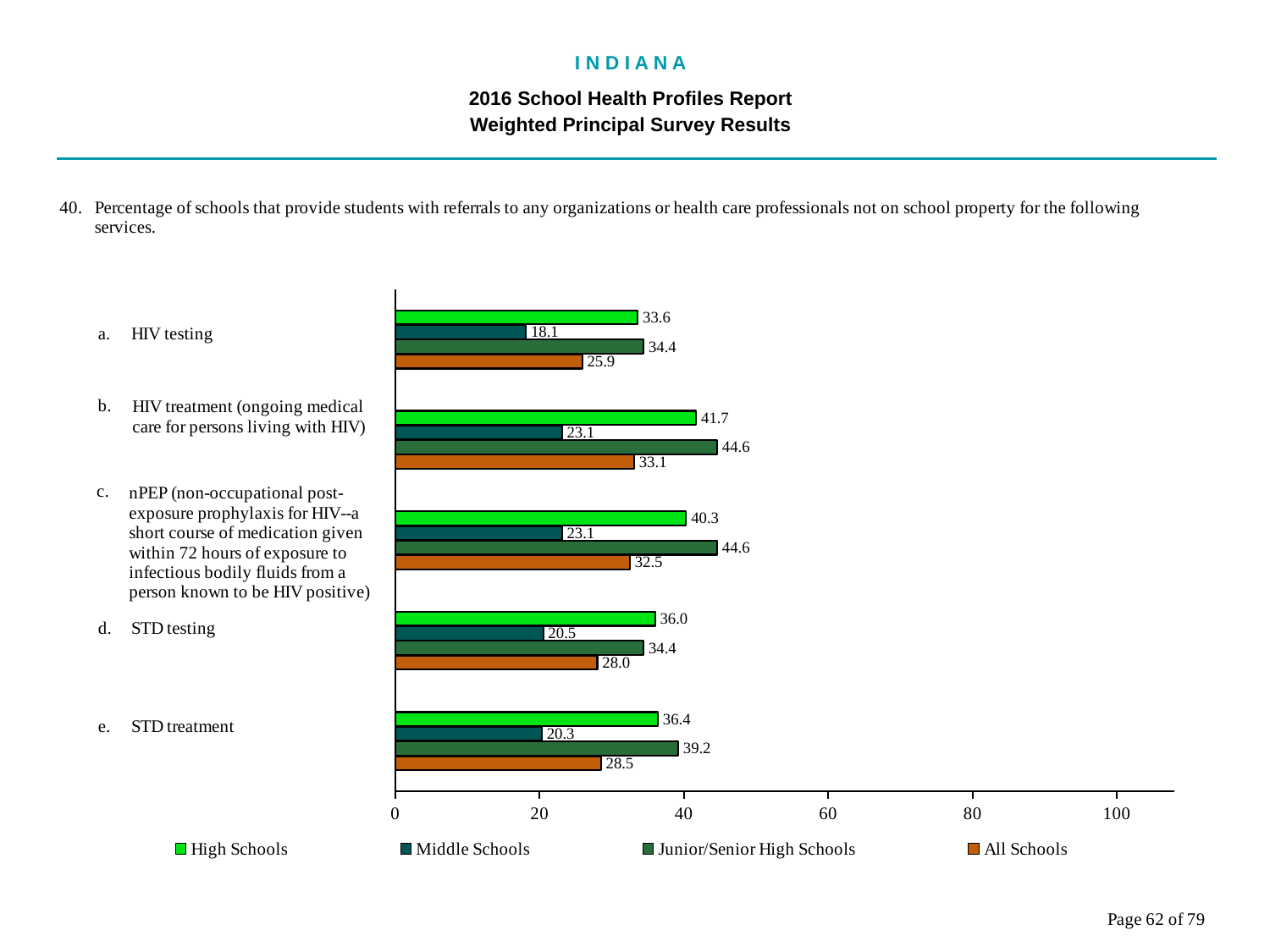
How many service categories are shown in the chart? 5 What is the value for All Schools for nPEP? 32.5 What is the difference between the Junior/Senior High Schools and Middle Schools values for HIV treatment? 21.5 How many series does the legend list? 4 Which category has the lowest value for All Schools? HIV testing What kind of chart is shown on the slide? bar chart Which is larger for STD testing: the High Schools value or the Junior/Senior High Schools value? High Schools Which category has the highest value for Middle Schools? HIV treatment and nPEP (both 23.1) Which legend entry is shown in orange? All Schools Is the value for Junior/Senior High Schools for nPEP greater or less than 40? greater What is the value for Middle Schools for STD treatment? 20.3 What is the value for High Schools for HIV testing? 33.6